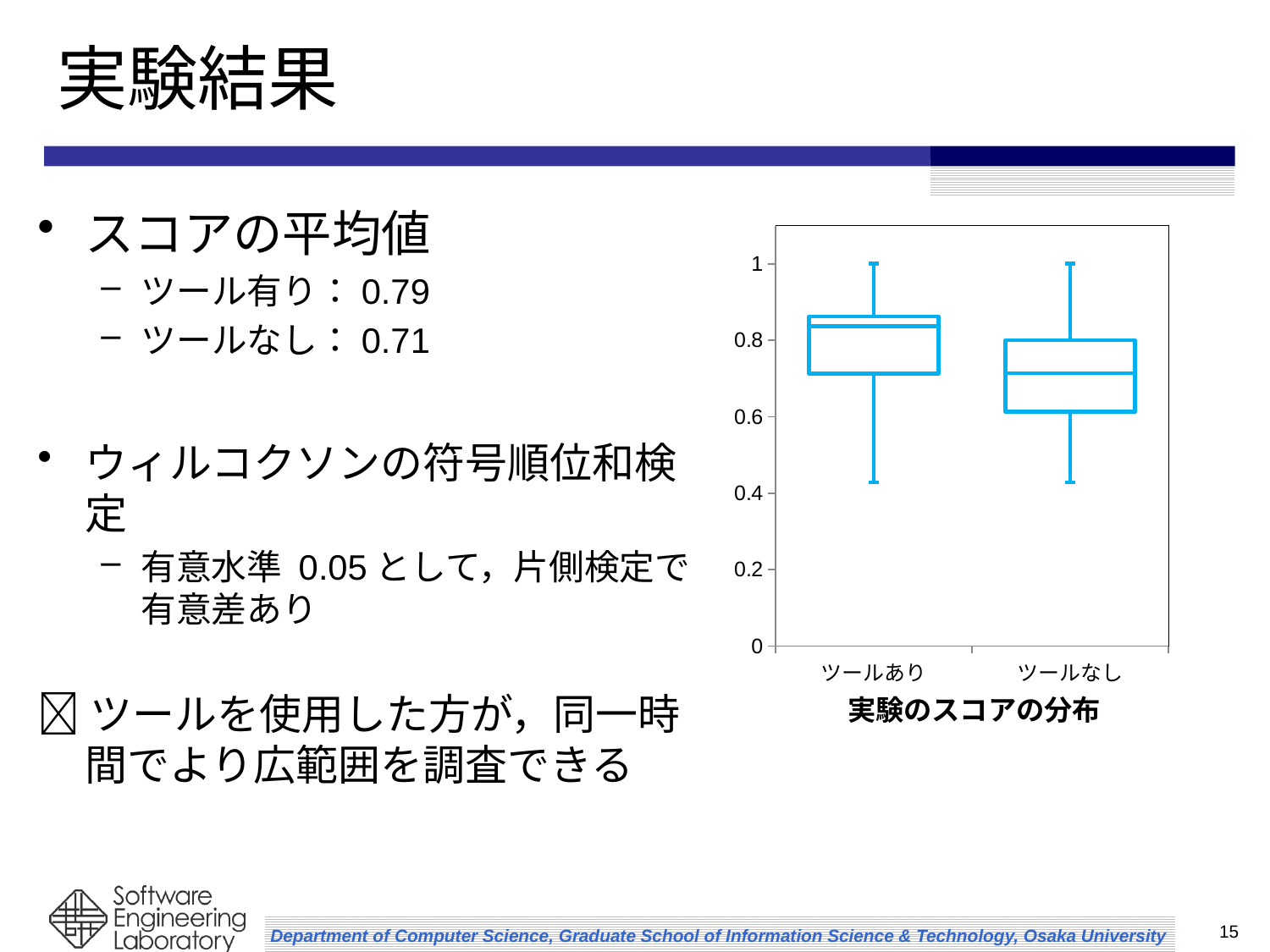
What is the title of the chart? 実験のスコアの分布 Which category has the higher median score in the box plot? ツールあり Is the lower whisker for ツールなし greater or less than 0.4? greater What is the maximum value reached by the upper whisker for ツールなし? 1 Is the median for ツールなし greater or less than 0.8? less How many categories are shown on the x axis of the chart? 2 What is the highest tick value shown on the y axis of the chart? 1 Is the lower whisker for ツールあり greater or less than 0.6? less What is the maximum value reached by the upper whisker for ツールあり? 1 What are the two category labels on the x axis of the chart? ツールあり, ツールなし What kind of chart is shown on the slide? box plot